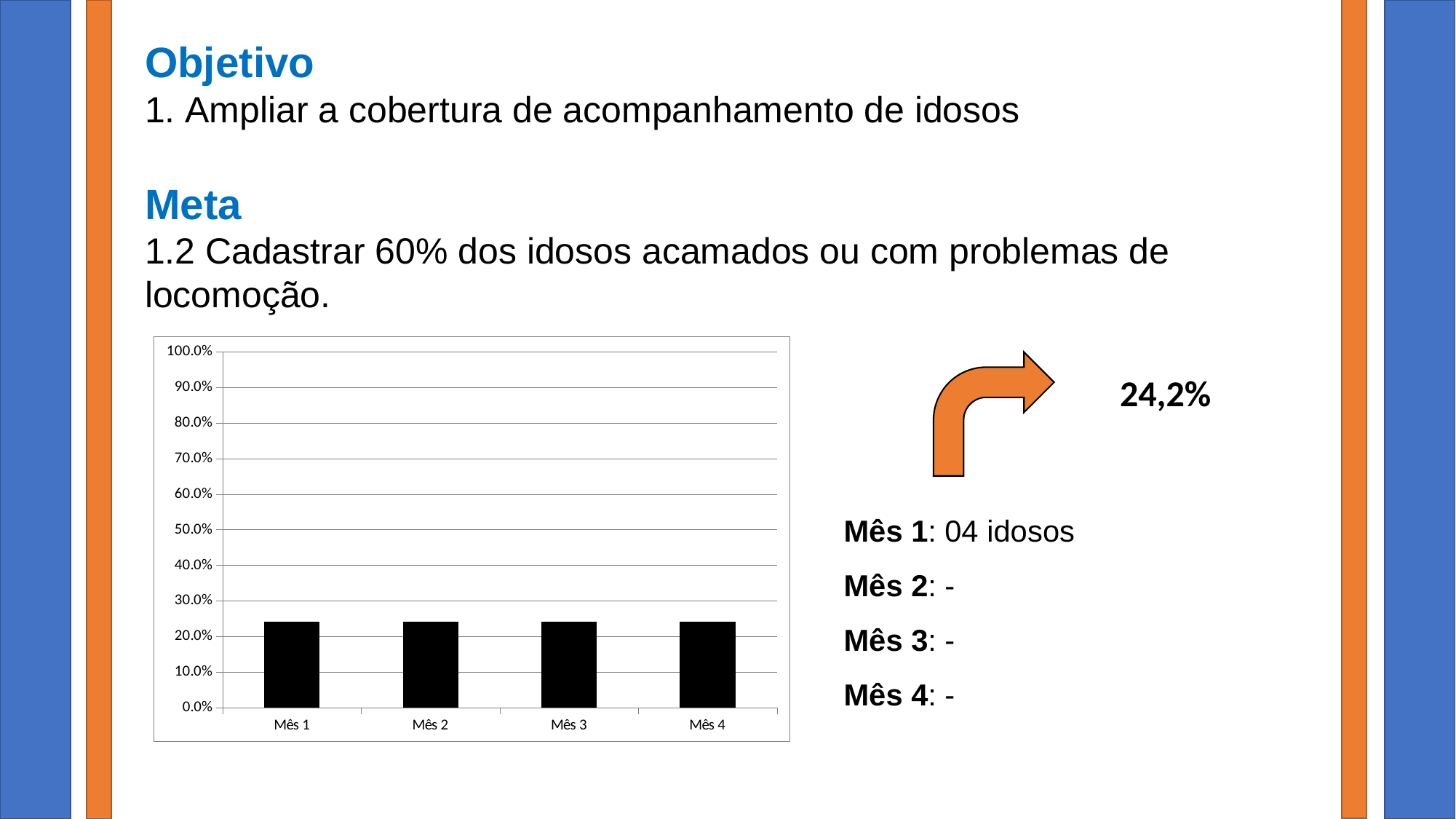
How many categories are plotted on the x axis of the chart? 4 Is the value for Mês 2 greater or less than 30.0%? less Do the bar values rise, fall or stay flat from Mês 1 to Mês 4? stay flat What colour are the bars in the chart? black What is the highest value shown on the chart's y axis? 100.0% Is the value for Mês 3 greater or less than 60.0%? less Is the value for Mês 4 greater or less than 50.0%? less What kind of chart is shown on the slide? bar chart What is the label of the first category on the x axis? Mês 1